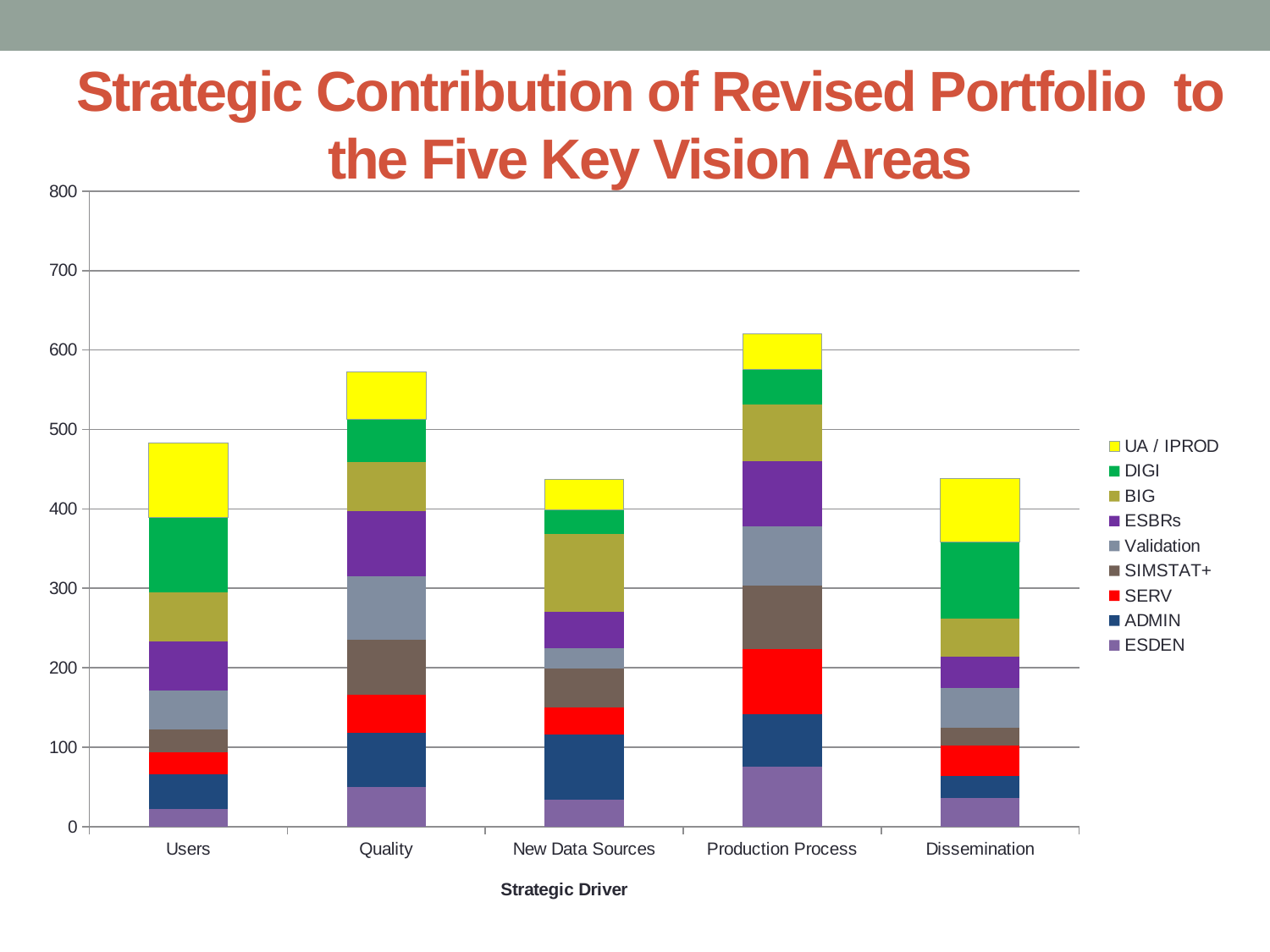
Which has the larger total, Production Process or Dissemination? Production Process What is the title of the x axis? Strategic Driver How many series does the chart's legend list? 9 Which has the larger total, Quality or Users? Quality How many categories are shown on the x axis of the chart? 5 Is the total for Production Process greater or less than 600? greater Which series is listed first (at the top) in the legend? UA / IPROD Is the total for Users greater or less than 500? less What kind of chart is shown on the slide? Stacked bar chart Is the total for New Data Sources greater or less than 500? less Which strategic driver has the tallest stacked bar? Production Process